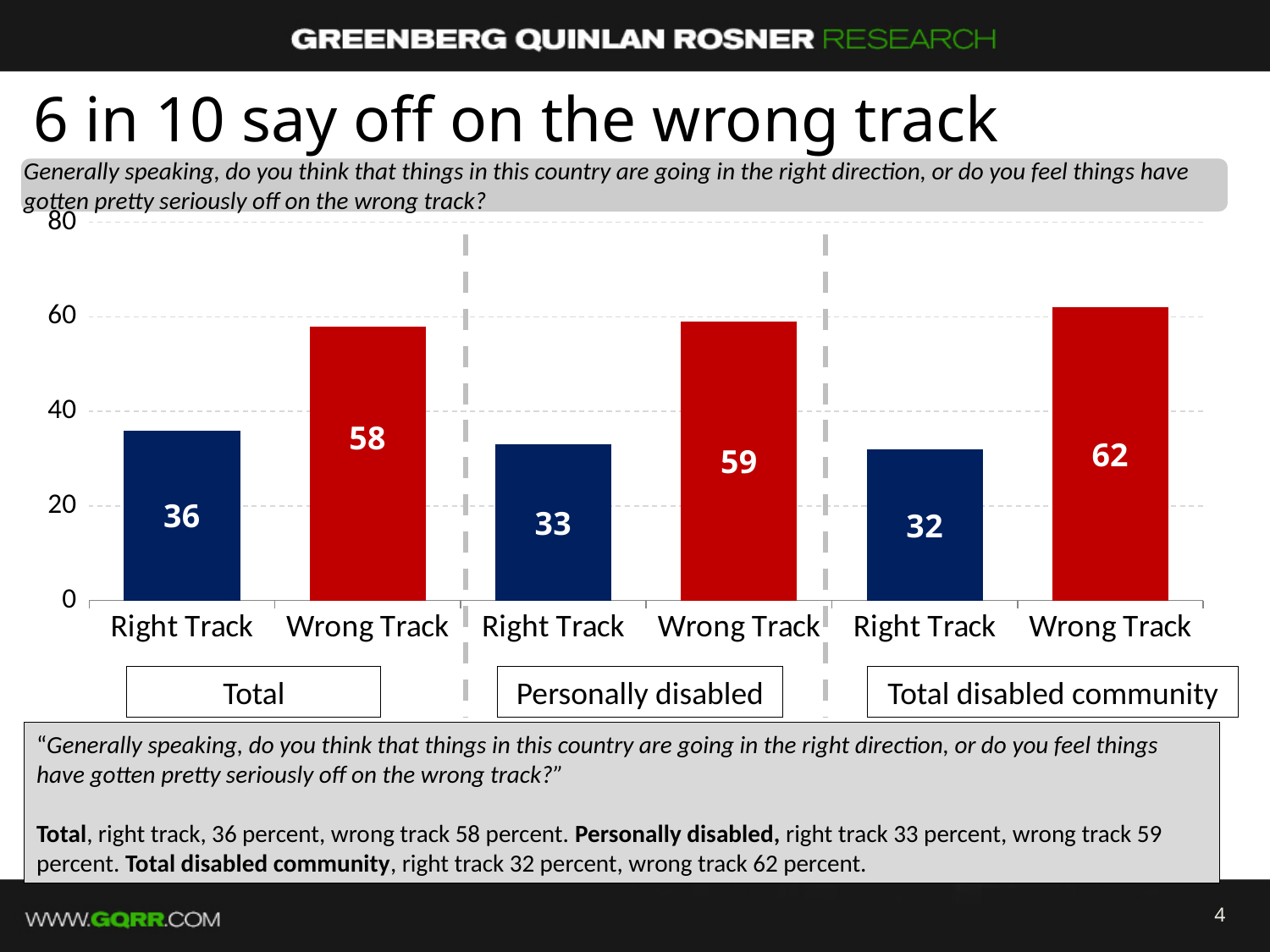
What is the value for Right Track in the Personally disabled group? 33 What is the value for Wrong Track in the Total disabled community group? 62 What kind of chart is shown on the slide? bar chart What is the difference between Wrong Track and Right Track in the Total disabled community group? 30 Which is larger: Right Track for Total or Right Track for Personally disabled? Right Track for Total How many bars are plotted on the chart? 6 What colour are the Wrong Track bars? red Which bar has the highest value on the chart? Wrong Track, Total disabled community Is the value for Wrong Track in the Total disabled community group greater or less than 60? greater What is the difference between Wrong Track and Right Track in the Total group? 22 Which bar has the lowest value on the chart? Right Track, Total disabled community What is the value for Wrong Track in the Total group? 58